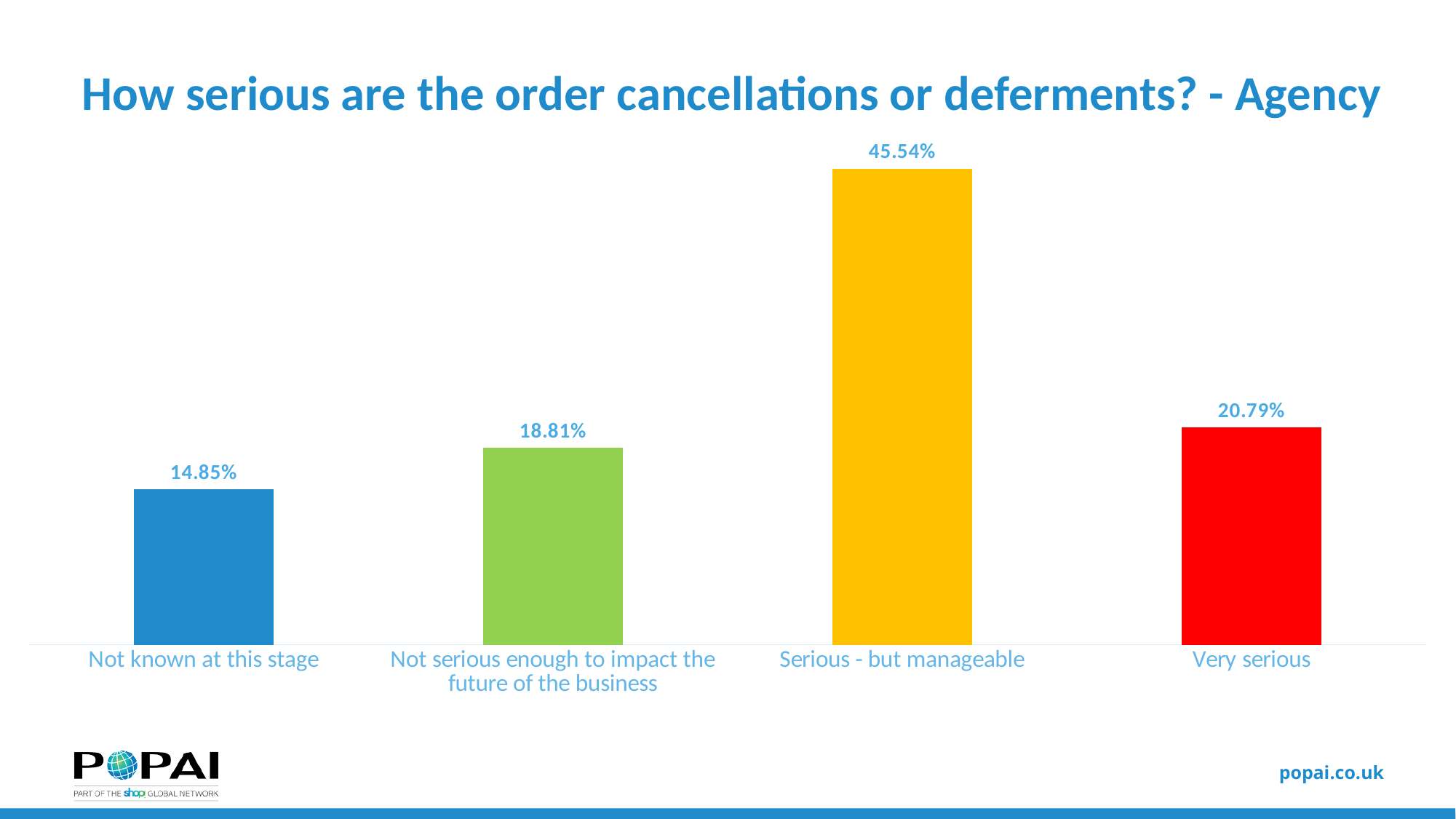
What is the difference between the values for "Serious - but manageable" and "Very serious"? 24.75% What is the value for "Serious - but manageable"? 45.54% What is the title of the chart? How serious are the order cancellations or deferments? - Agency What is the value for "Not serious enough to impact the future of the business"? 18.81% Which category has the lowest value? Not known at this stage What is the value for "Not known at this stage"? 14.85% Which is larger: the value for "Very serious" or the value for "Not known at this stage"? Very serious What is the difference between the values for "Not serious enough to impact the future of the business" and "Not known at this stage"? 3.96% What kind of chart is shown on the slide? Bar chart Which category has the highest value? Serious - but manageable What is the value for "Very serious"? 20.79% How many categories are shown in the chart? 4